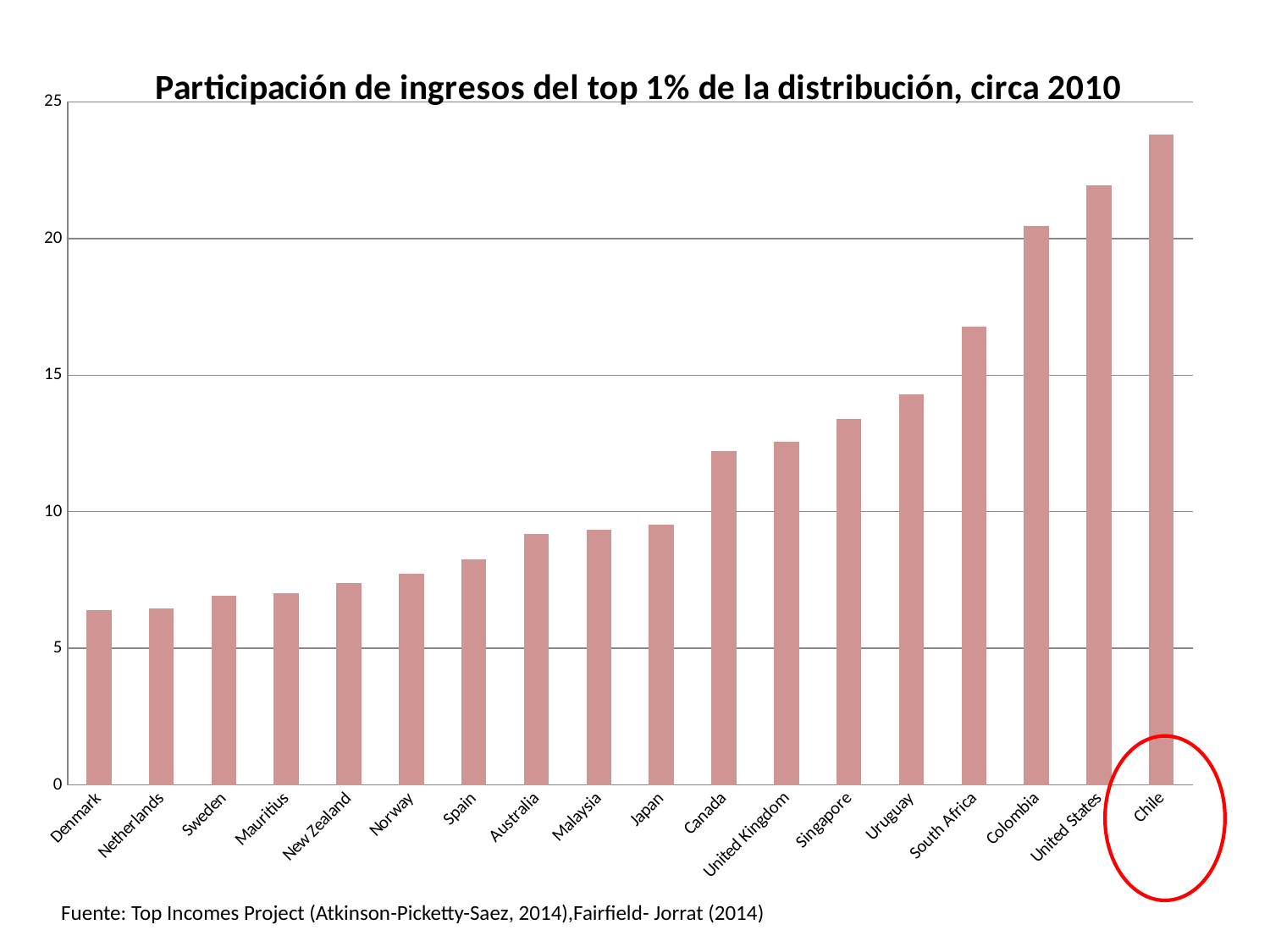
Is the value for South Africa greater or less than 15? greater What kind of chart is shown on the slide? bar chart Is the value for Canada greater or less than 10? greater Which country has the highest top 1% income share in the chart? Chile Which is larger, the value for Chile or the value for United States? Chile Is the value for Chile greater or less than 20? greater Which country's bar is circled in red on the slide? Chile How many countries are shown in the chart? 18 Do the values rise or fall moving from left to right along the x axis? rise Which country has the lowest top 1% income share in the chart? Denmark